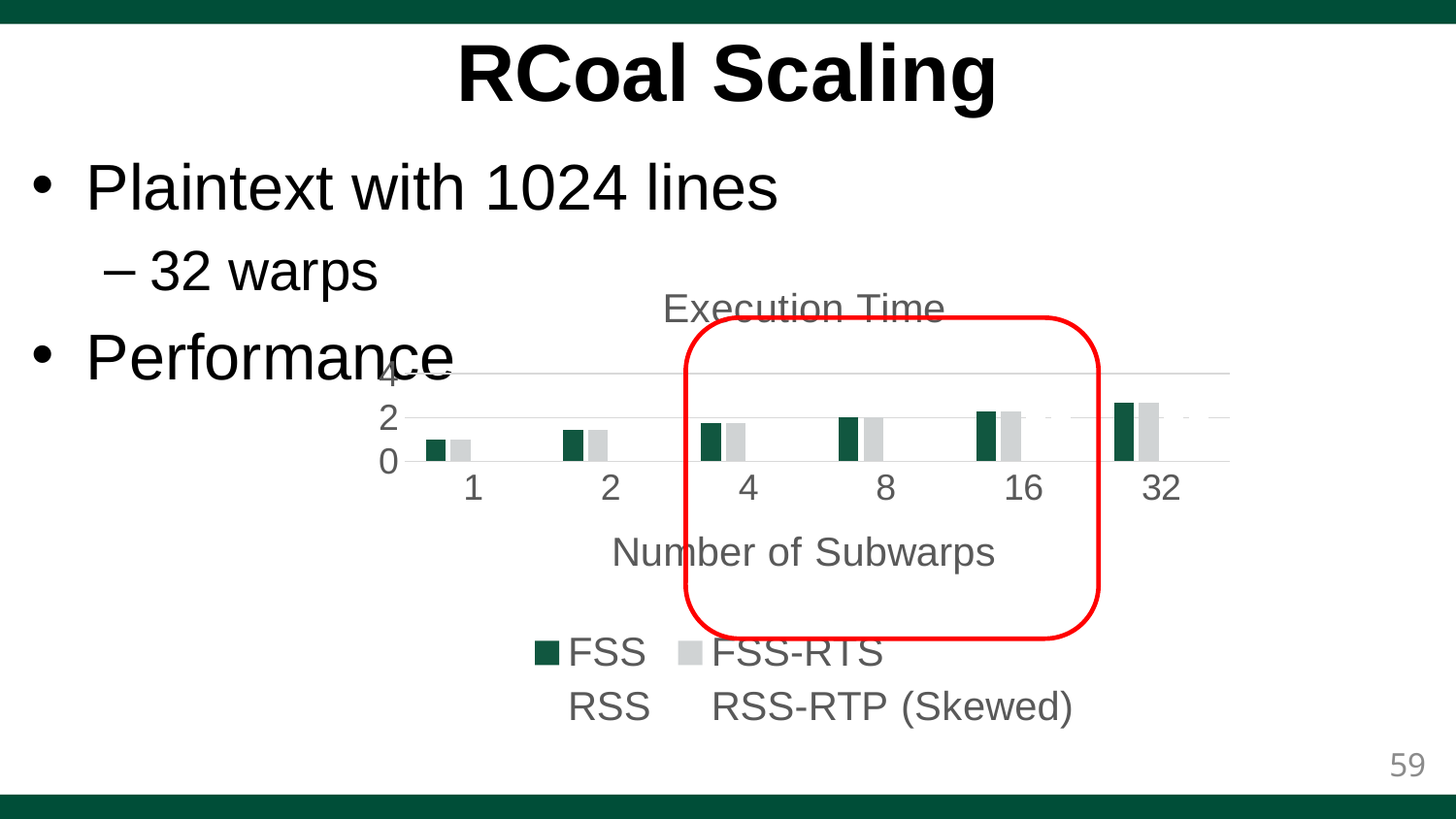
What is the title of the chart? Execution Time Which number of subwarps has the highest FSS execution time? 32 Is the FSS value for 1 subwarp greater or less than 2? less What is the label of the x axis of the chart? Number of Subwarps Do the FSS execution times rise or fall as the number of subwarps increases? rise Which is larger, the FSS value for 32 subwarps or the FSS value for 1 subwarp? 32 subwarps How many categories (numbers of subwarps) are shown on the x axis? 6 Is the FSS value for 32 subwarps greater or less than 2? greater Is the FSS-RTS value for 2 subwarps greater or less than 2? less Which number of subwarps has the lowest FSS execution time? 1 What kind of chart is shown on the slide? bar chart How many series does the legend list? 4